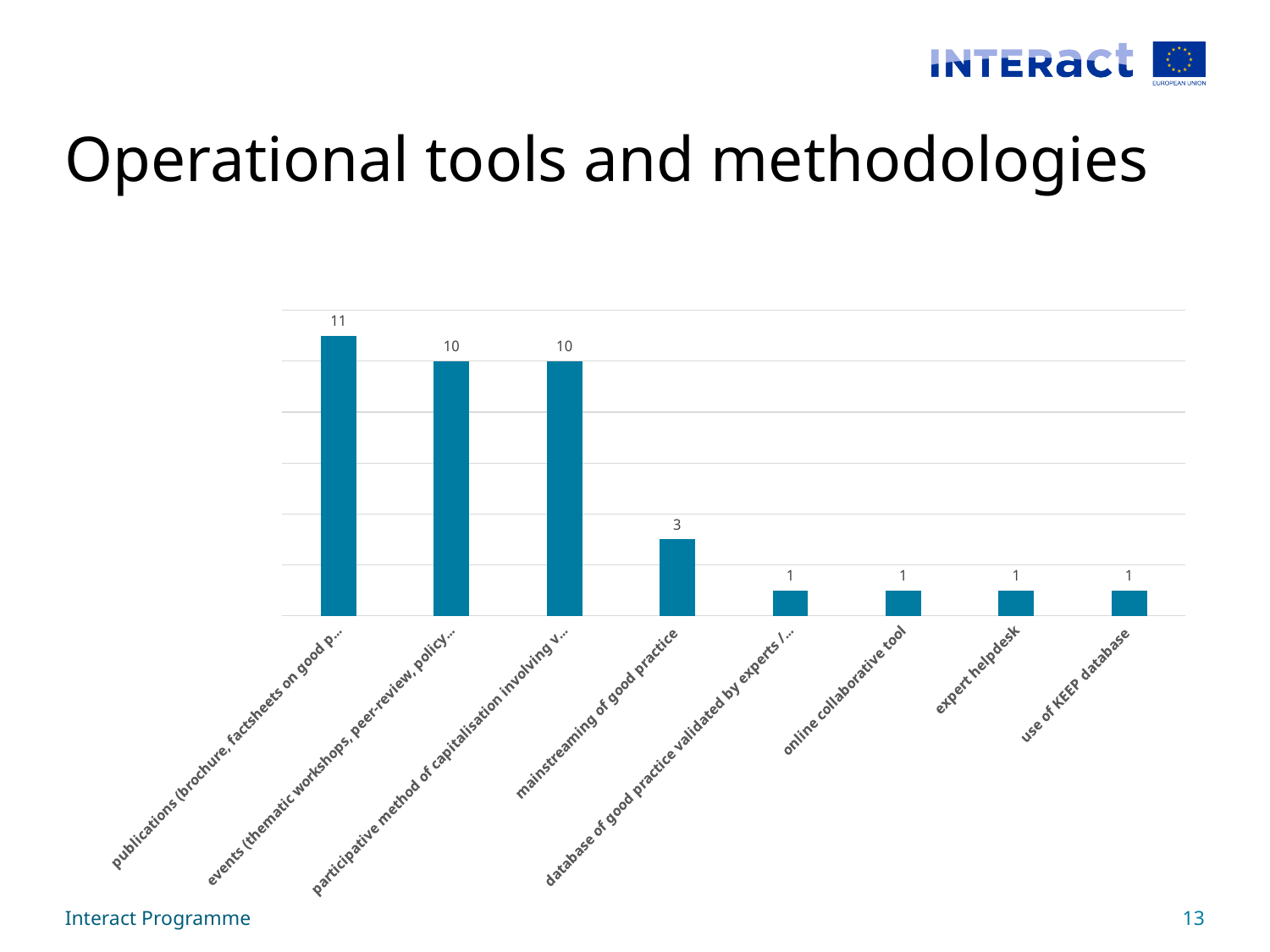
How many categories (bars) does the chart show? 8 What is the highest value shown in the chart? 11 Which category has the highest value? publications (brochure, factsheets on good p...) What is the value for "use of KEEP database"? 1 What is the value for "online collaborative tool"? 1 What is the difference between the value for publications and the value for "mainstreaming of good practice"? 8 Do the values rise or fall from left to right along the x axis? fall What is the value for "mainstreaming of good practice"? 3 What kind of chart is shown on the slide? bar chart What is the value for "expert helpdesk"? 1 Which is larger: the value for publications or the value for events? publications What is the title of the slide containing the chart? Operational tools and methodologies